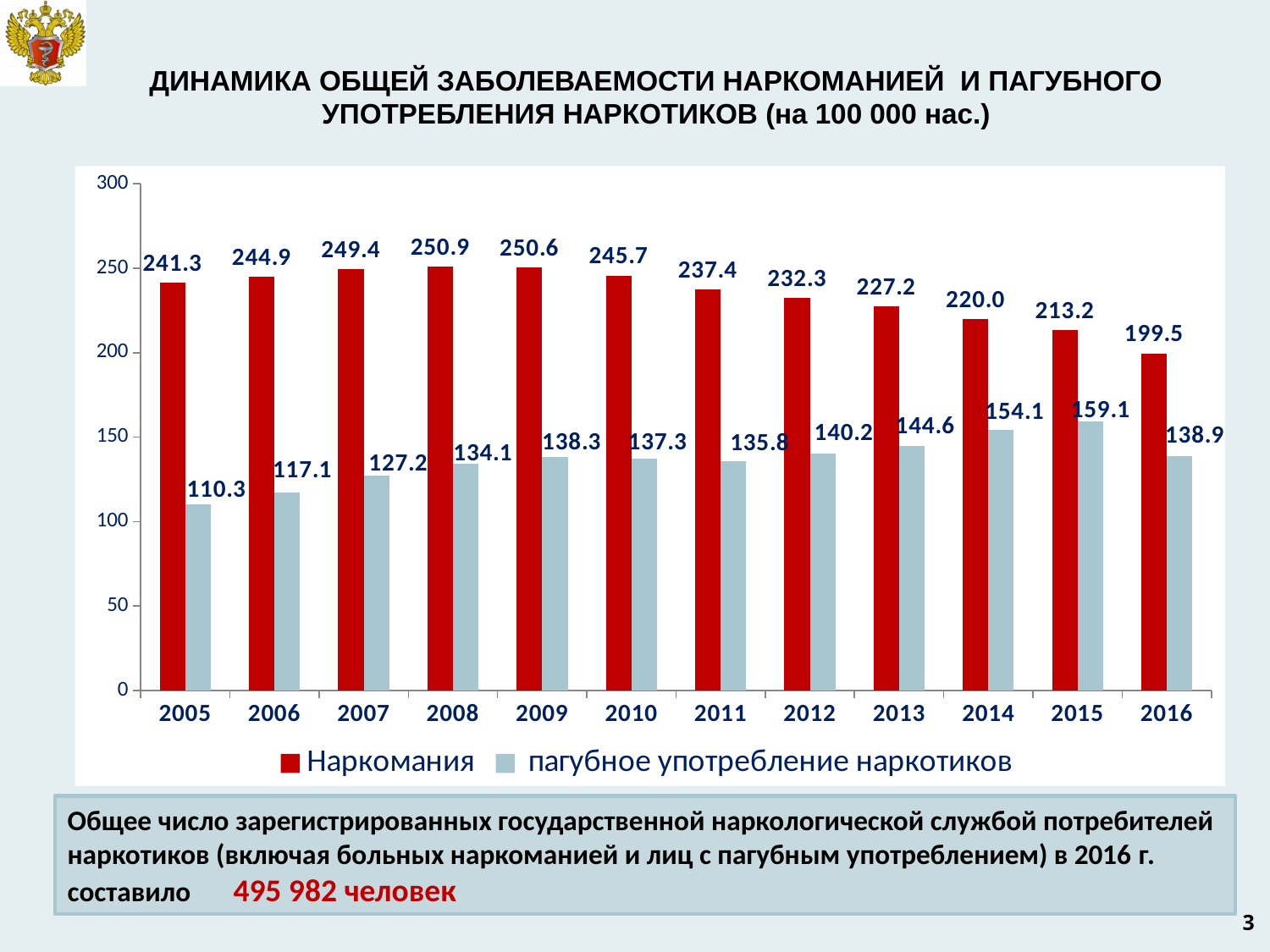
What is the value for пагубное употребление наркотиков in 2015? 159.1 In which year is the Наркомания value the lowest? 2016 In which year is the пагубное употребление наркотиков value the lowest? 2005 In which year is the пагубное употребление наркотиков value the highest? 2015 What kind of chart is shown on the slide? Bar chart Does the Наркомания value rise or fall from 2008 to 2016? Fall What is the difference between the Наркомания and пагубное употребление наркотиков values in 2016? 60.6 What is the value for Наркомания in 2008? 250.9 Which year has the larger пагубное употребление наркотиков value, 2013 or 2014? 2014 How many series does the legend list? 2 By how much did the Наркомания value decrease from 2005 to 2016? 41.8 How many years are shown on the x axis? 12